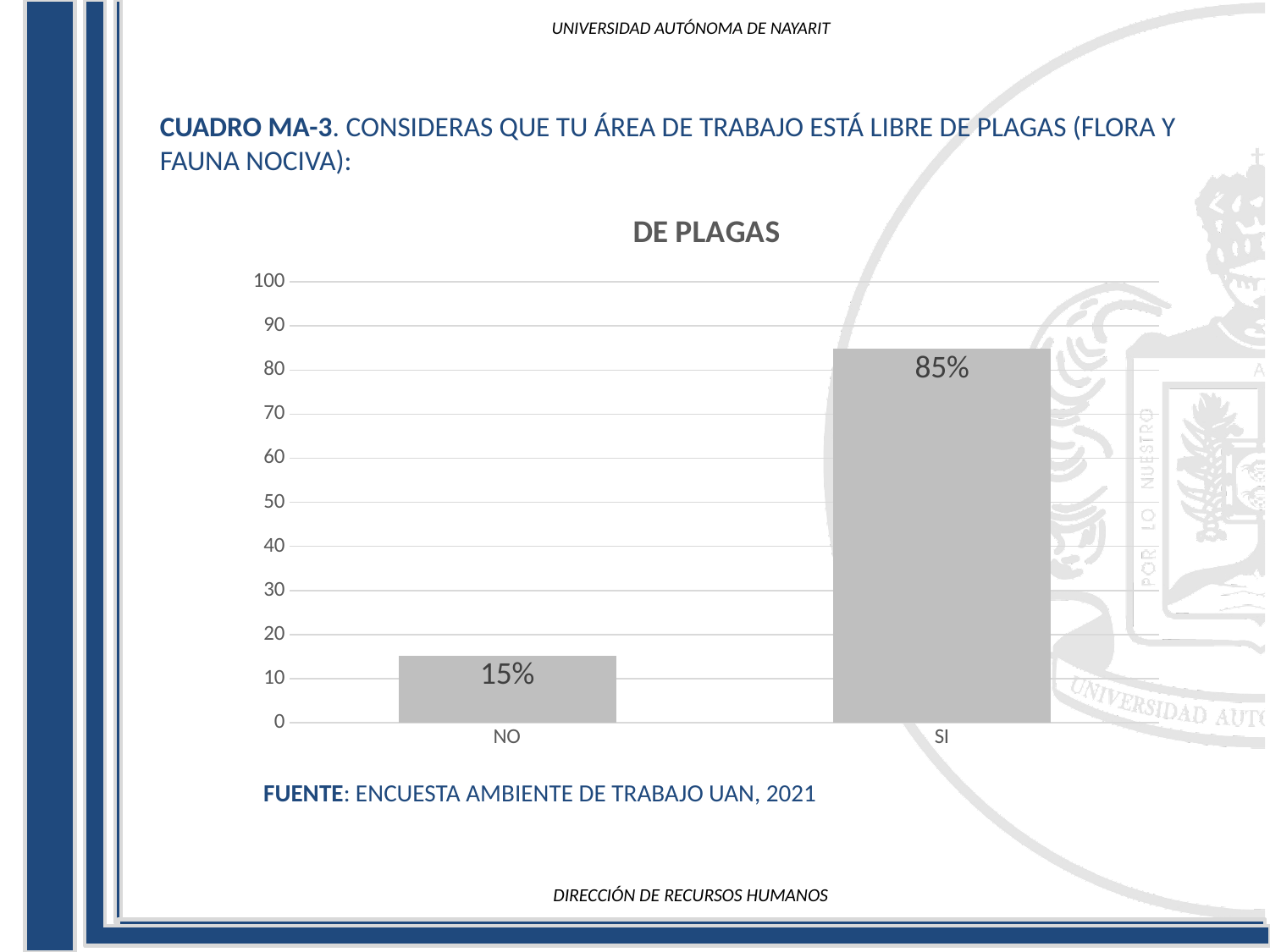
Which is larger, the value for NO or the value for SI? SI Which category has the lowest value? NO What kind of chart is shown on the slide? bar chart What is the difference between the values for SI and NO? 70% What is the value for SI? 85% How many categories are shown on the x axis? 2 Which category has the highest value? SI What is the value for NO? 15% What is the title shown above the chart? DE PLAGAS Is the value for SI greater or less than 80? greater What is the highest value shown on the y axis? 100 Is the value for NO greater or less than 20? less